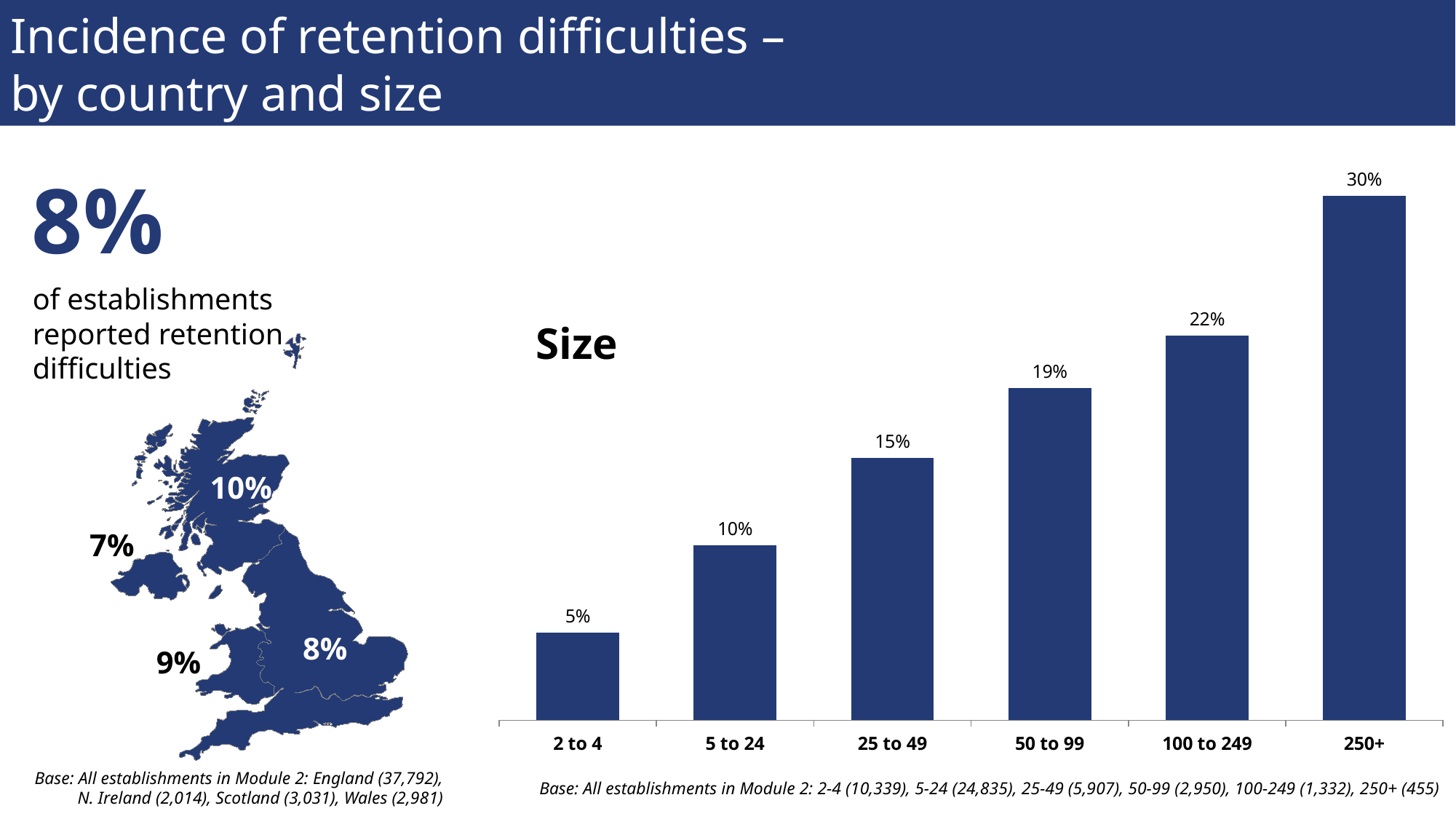
In the Size bar chart, what is the difference between the values for 250+ and 2 to 4? 25 percentage points In the Size bar chart, what is the difference between the values for 100 to 249 and 25 to 49? 7 percentage points What kind of chart is the Size chart? Bar chart In the Size bar chart, what is the value for establishments with 250+ employees? 30% In the Size bar chart, which size band has the highest value? 250+ In the Size bar chart, what is the value for the 2 to 4 size band? 5% In the Size bar chart, do the values rise or fall as establishment size increases from left to right? Rise On the map, what percentage is shown for Scotland? 10% In the Size bar chart, which size band has the lowest value? 2 to 4 In the Size bar chart, what is the value for the 50 to 99 size band? 19% In the Size bar chart, which is larger: the value for 5 to 24 or the value for 25 to 49? 25 to 49 How many size bands are shown in the Size bar chart? 6